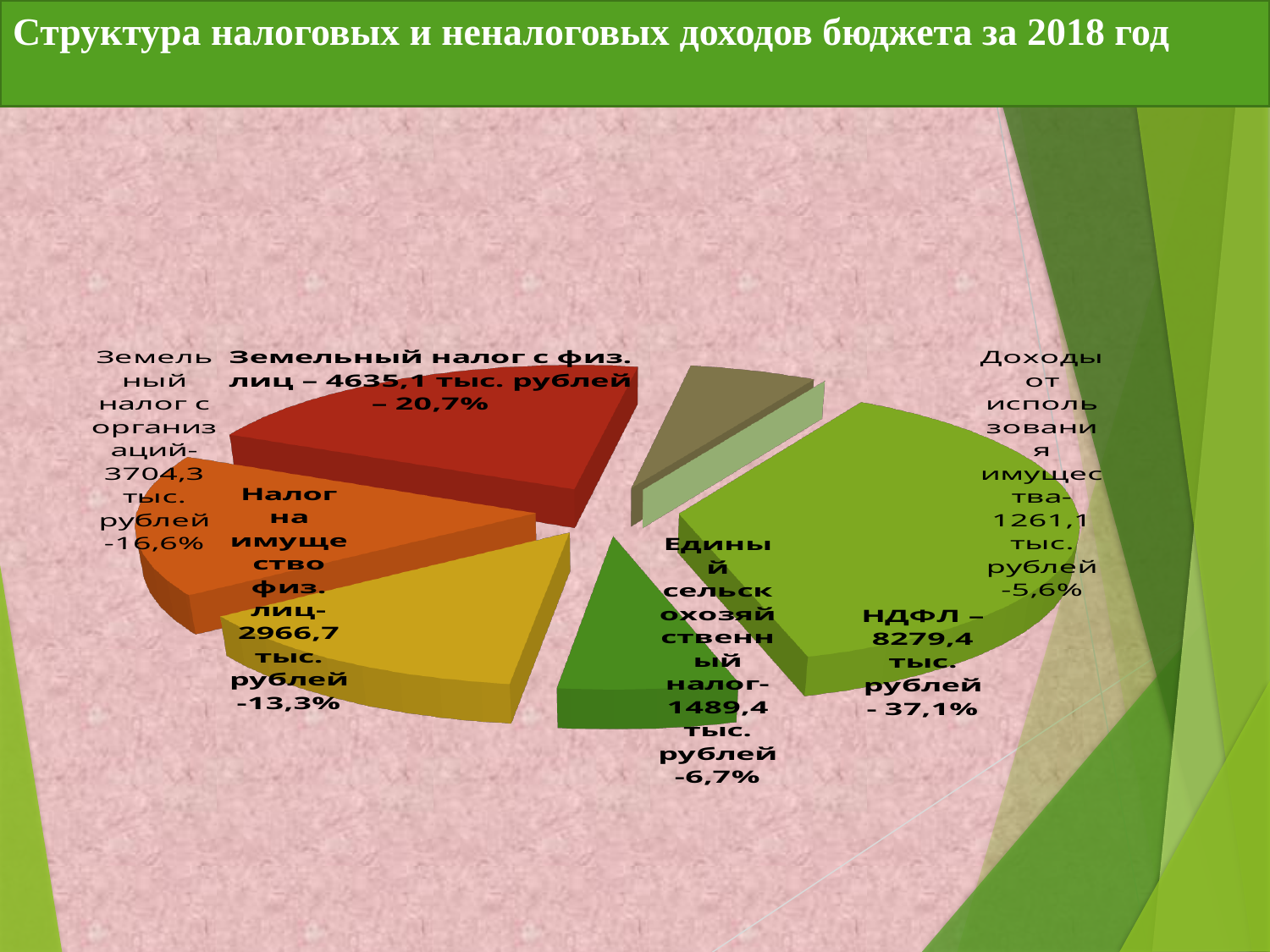
Как называется диаграмма на слайде? Структура налоговых и неналоговых доходов бюджета за 2018 год Какую долю составляет земельный налог с организаций? 16,6% Какую долю составляет НДФЛ? 37,1% Какова сумма НДФЛ по диаграмме? 8279,4 тыс. рублей Какой тип диаграммы показан на слайде? Круговая диаграмма Какова сумма земельного налога с физ. лиц? 4635,1 тыс. рублей Какую долю составляют доходы от использования имущества? 5,6% На сколько тыс. рублей НДФЛ больше земельного налога с физ. лиц? 3644,3 тыс. рублей Какая из подписанных статей доходов имеет наименьшую долю? Доходы от использования имущества Какая статья доходов имеет наибольшую долю? НДФЛ Какова сумма налога на имущество физ. лиц? 2966,7 тыс. рублей Что больше: земельный налог с организаций или единый сельскохозяйственный налог? Земельный налог с организаций